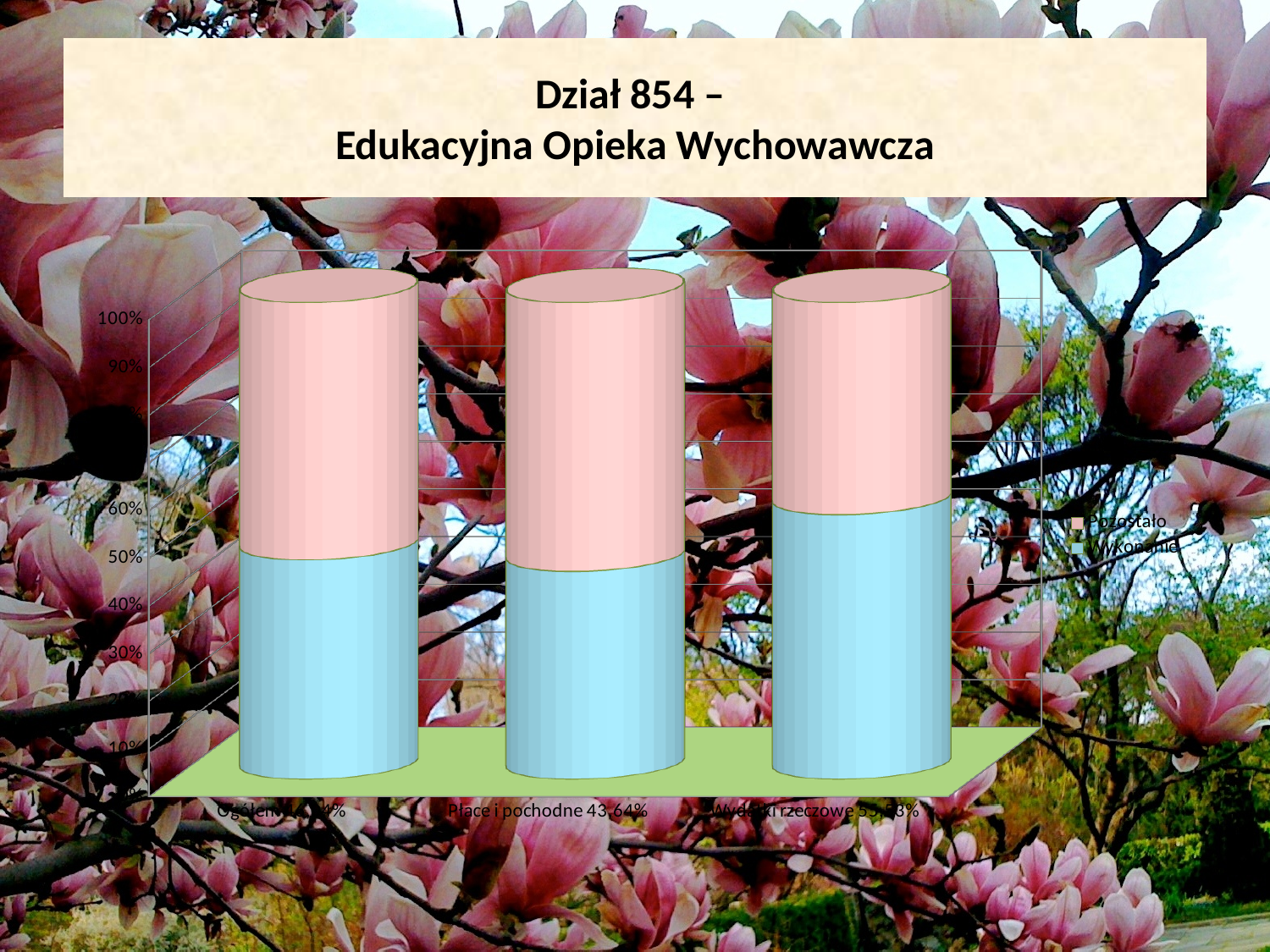
What kind of chart is shown on the slide? Stacked bar chart Which has the larger Wykonanie share: Wydatki rzeczowe or Płace i pochodne? Wydatki rzeczowe How many series does the chart's legend list? 2 Is the Wykonanie value for Płace i pochodne greater or less than 50%? less What is the highest value shown on the chart's vertical axis? 100% Which colour represents the Wykonanie series in the chart? Blue Is the Wykonanie value for Wydatki rzeczowe greater or less than 50%? greater Which category has the highest Wykonanie share? Wydatki rzeczowe What are the two series named in the chart's legend? Pozostało and Wykonanie How many categories are shown on the x axis of the chart? 3 What Wykonanie percentage is printed for the category Płace i pochodne? 43,64% Which category has the lowest Wykonanie share? Płace i pochodne